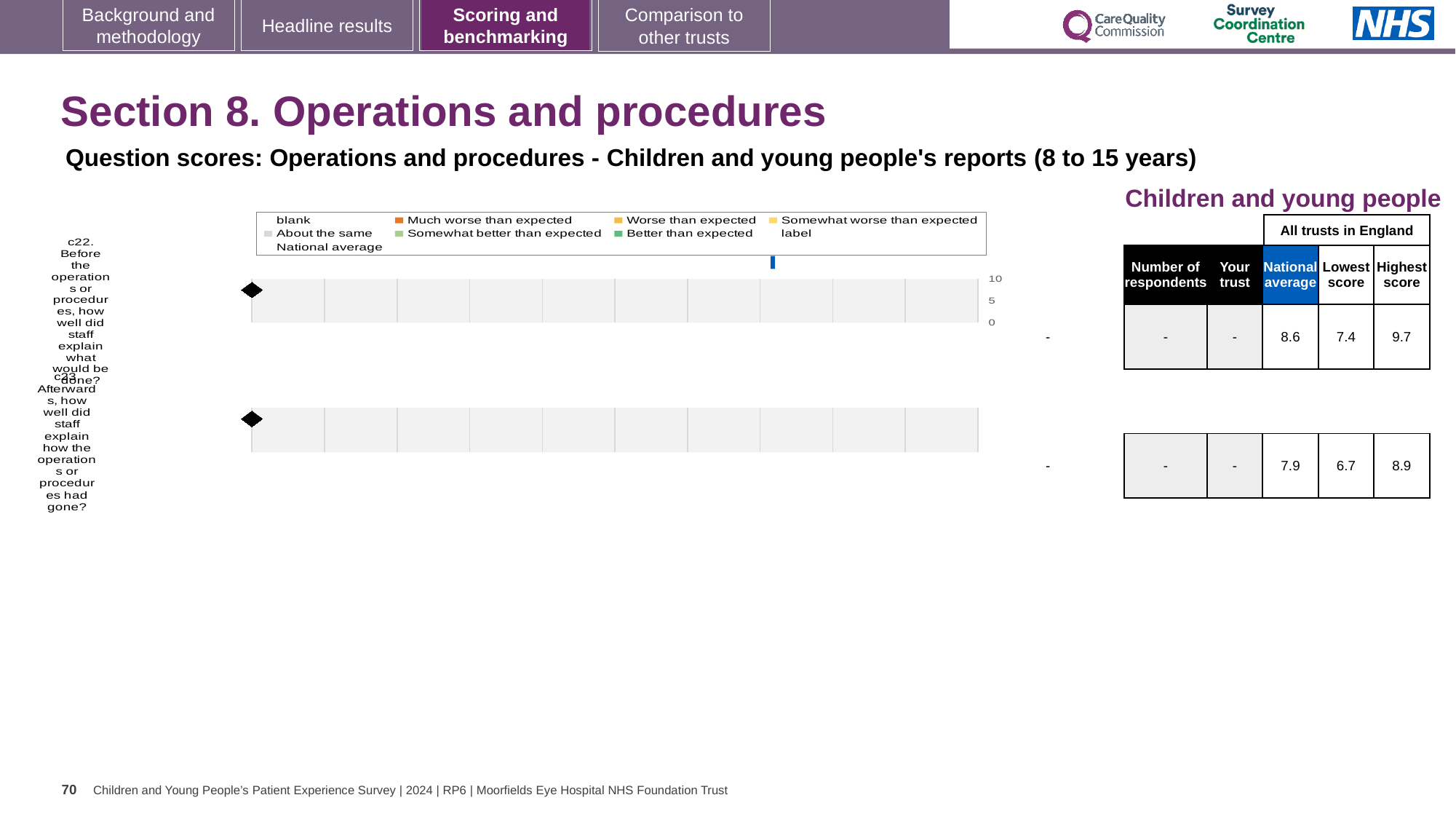
In the table next to the chart, which question has the higher National average, c22 or c23? c22 What colour is the legend marker for 'Much worse than expected'? orange In the table next to the chart, which question has the higher Highest score? c22 In the table next to the chart, what is the Highest score for c23 (Afterwards, how well did staff explain how the operations or procedures had gone)? 8.9 In the table next to the chart, what is the National average score for c22 (Before the operations or procedures, how well did staff explain what would be done)? 8.6 In the table next to the chart, what is the difference between the Highest score and the Lowest score for c22? 2.3 In the table next to the chart, what is the Lowest score for c23? 6.7 How many entries does the chart's legend list? 9 How many question categories are listed on the chart's vertical axis? 2 What kind of chart is shown on the slide? bar chart What is the highest tick value shown on the chart's horizontal axis? 10 In the table next to the chart, what is the difference between the National average scores of c22 and c23? 0.7